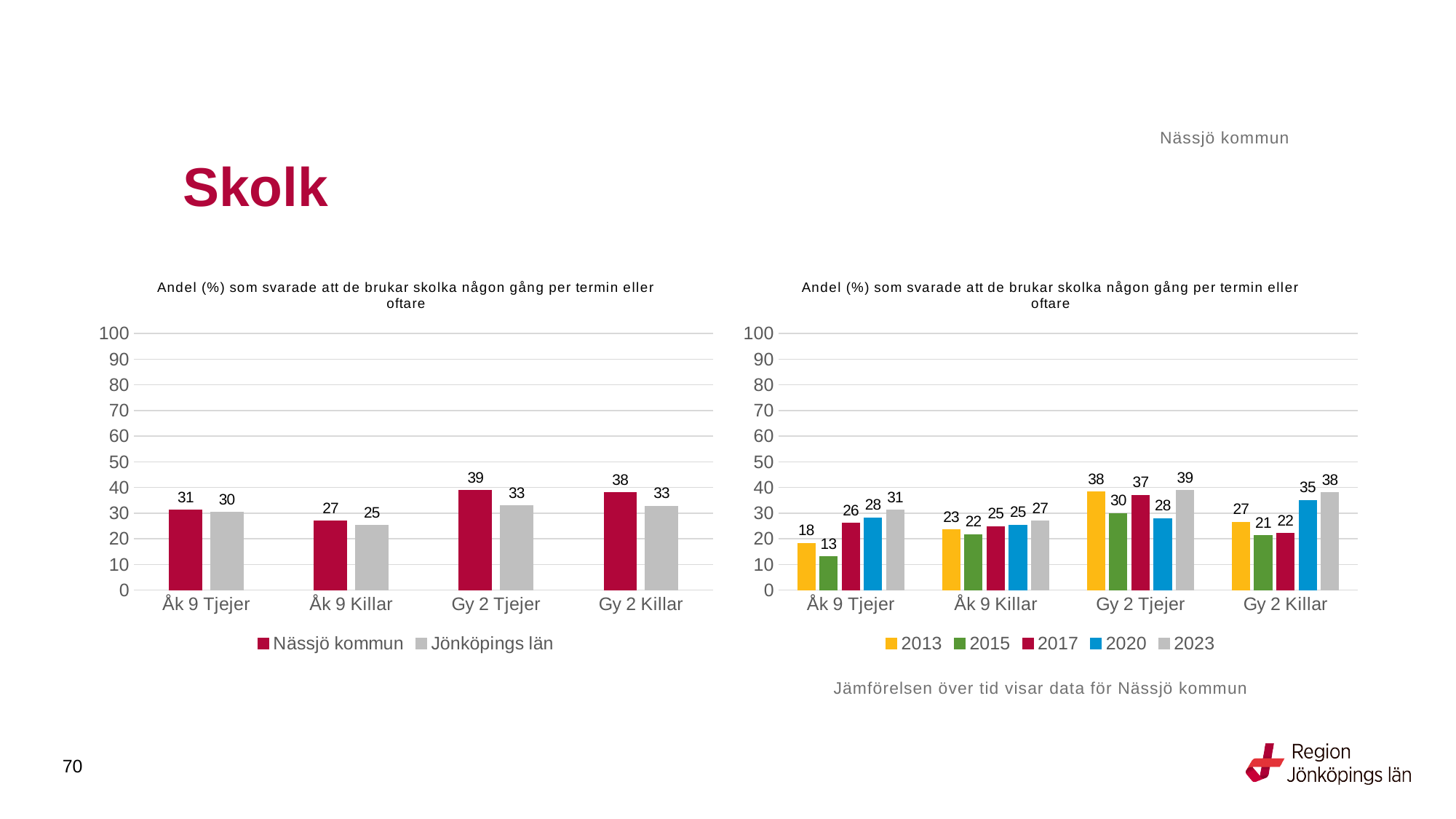
In the right chart, what is the value for 2020 for Gy 2 Killar? 35 In the right chart, what is the value for 2015 for Åk 9 Tjejer? 13 In the left chart, how many series does the legend list? 2 In the right chart, how many categories are shown on the x axis? 4 In the left chart, what is the value for Nässjö kommun for Gy 2 Tjejer? 39 In the left chart, what is the difference between Nässjö kommun and Jönköpings län for Gy 2 Tjejer? 6 In the left chart, which category has the lowest value for Nässjö kommun? Åk 9 Killar In the right chart, is the 2013 value for Gy 2 Tjejer larger or the 2020 value for Gy 2 Tjejer? 2013 In the left chart, what is the value for Jönköpings län for Åk 9 Killar? 25 What kind of chart is the left chart? Bar chart In the right chart, how many series does the legend list? 5 In the right chart, which year has the highest value for Gy 2 Tjejer? 2023